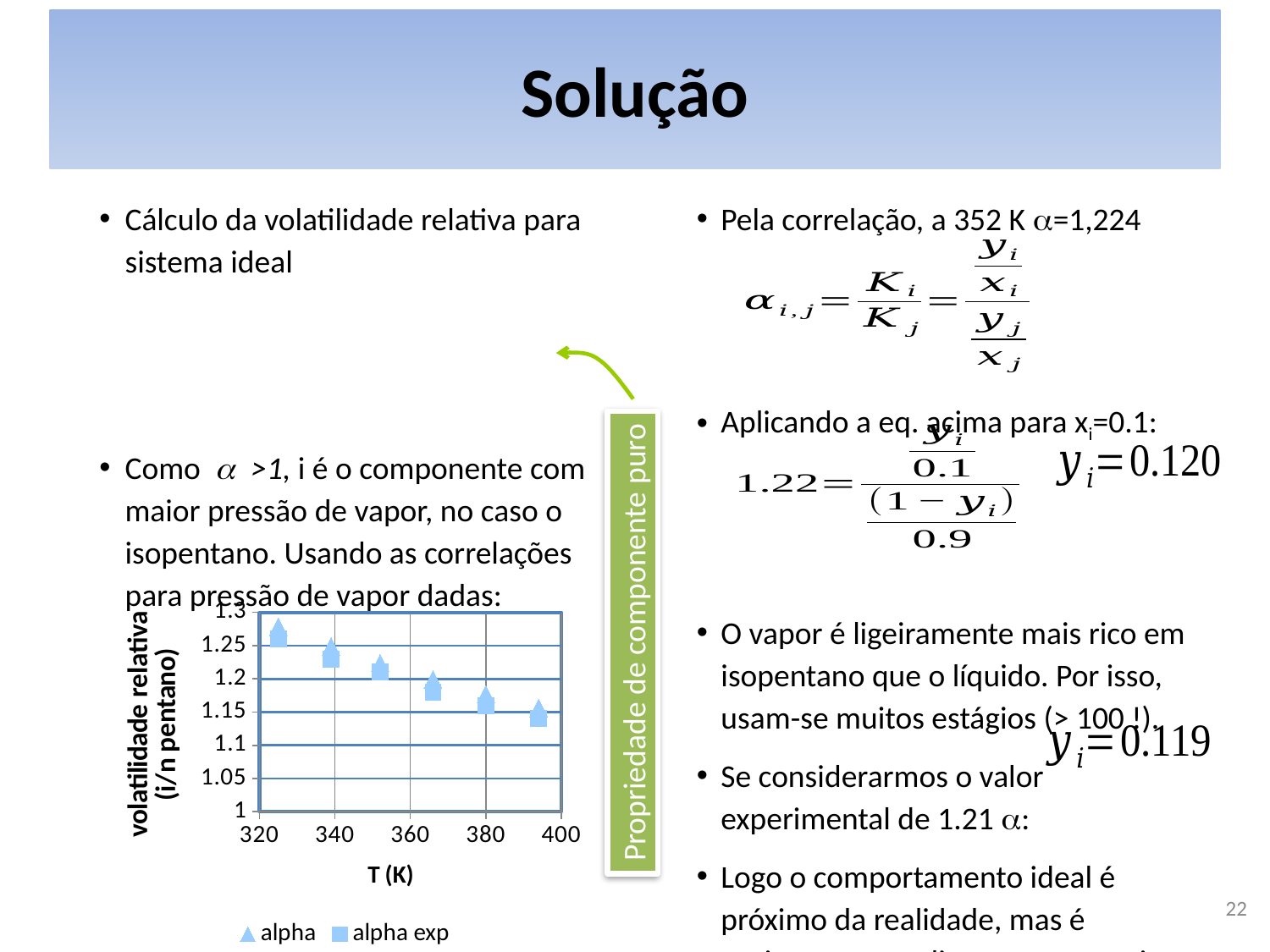
Is the alpha value at about 380 K greater or less than 1.2? less Which is larger for the alpha series: the value at about 325 K or the value at about 394 K? the value at about 325 K Is the alpha value at the lowest temperature (around 325 K) greater or less than 1.25? greater Is the alpha exp value at about 339 K greater or less than 1.2? greater Do the alpha values rise or fall as T (K) increases? fall What kind of chart is shown on the slide? scatter chart What are the two series named in the chart legend? alpha and alpha exp What is the title of the x axis of the chart? T (K) How many series does the chart legend list? 2 How many data points are plotted for the alpha series? 6